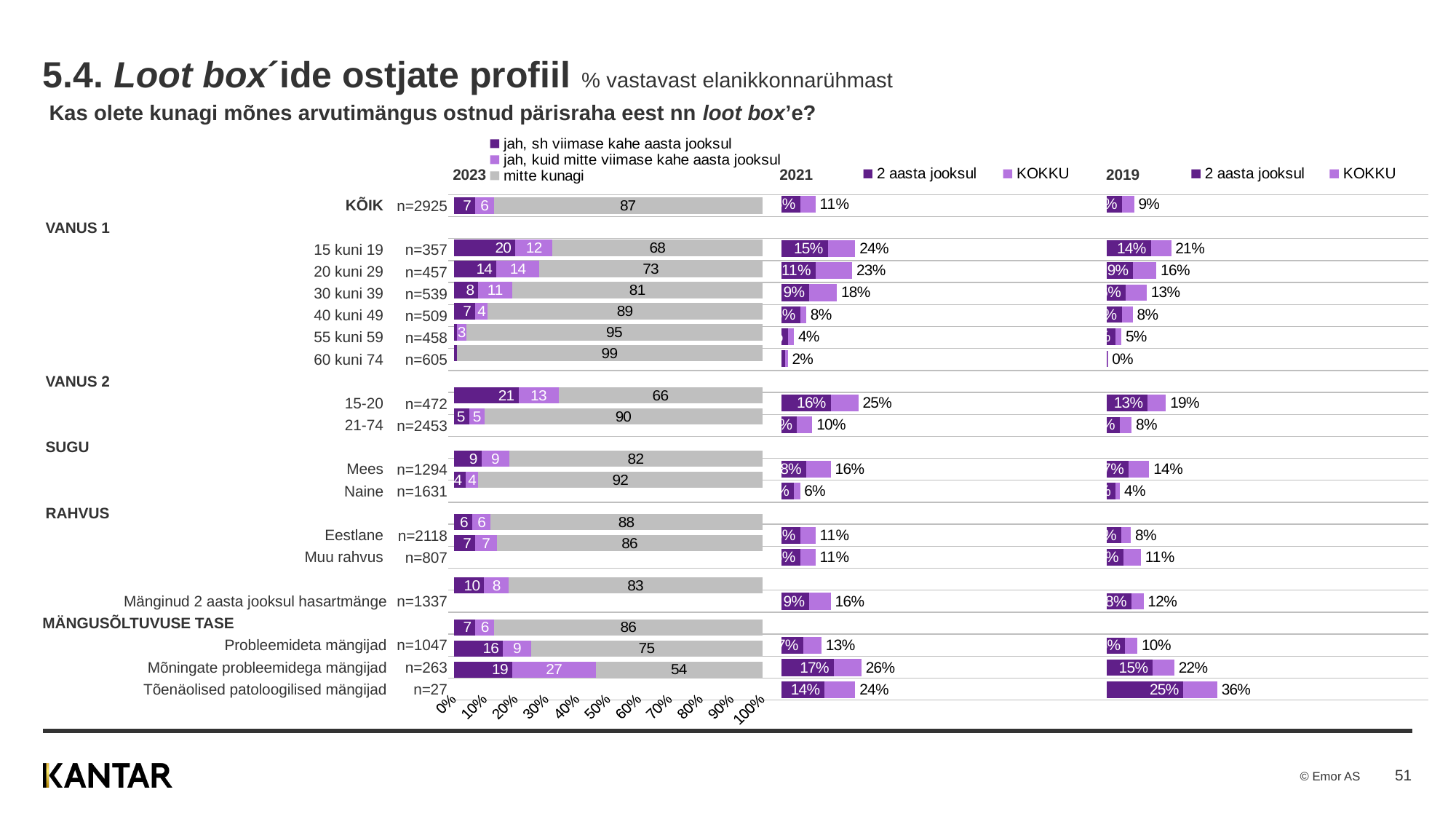
In the 2023 chart, which category has the lowest 'mitte kunagi' value? Tõenäolised patoloogilised mängijad In the 2023 chart, what is the value of 'jah, kuid mitte viimase kahe aasta jooksul' for Tõenäolised patoloogilised mängijad? 27 What kind of chart is the 2023 chart? Stacked bar chart In the 2023 chart, what is the value of 'mitte kunagi' for KÕIK? 87 In the 2021 chart, what is the '2 aasta jooksul' value for Mõningate probleemidega mängijad? 17% How many series does the legend of the 2023 chart list? 3 In the 2021 chart, what is the KOKKU value for 15-20? 25% In the 2023 chart, what is the value of 'jah, sh viimase kahe aasta jooksul' for 15 kuni 19? 20 In the 2023 chart, which category has the highest 'mitte kunagi' value? 60 kuni 74 In the 2019 chart, which is larger, the KOKKU value for Mees or for Naine? Mees In the 2019 chart, what is the KOKKU value for Tõenäolised patoloogilised mängijad? 36% In the 2023 chart, what is the difference between the 'mitte kunagi' values for Naine and Mees? 10